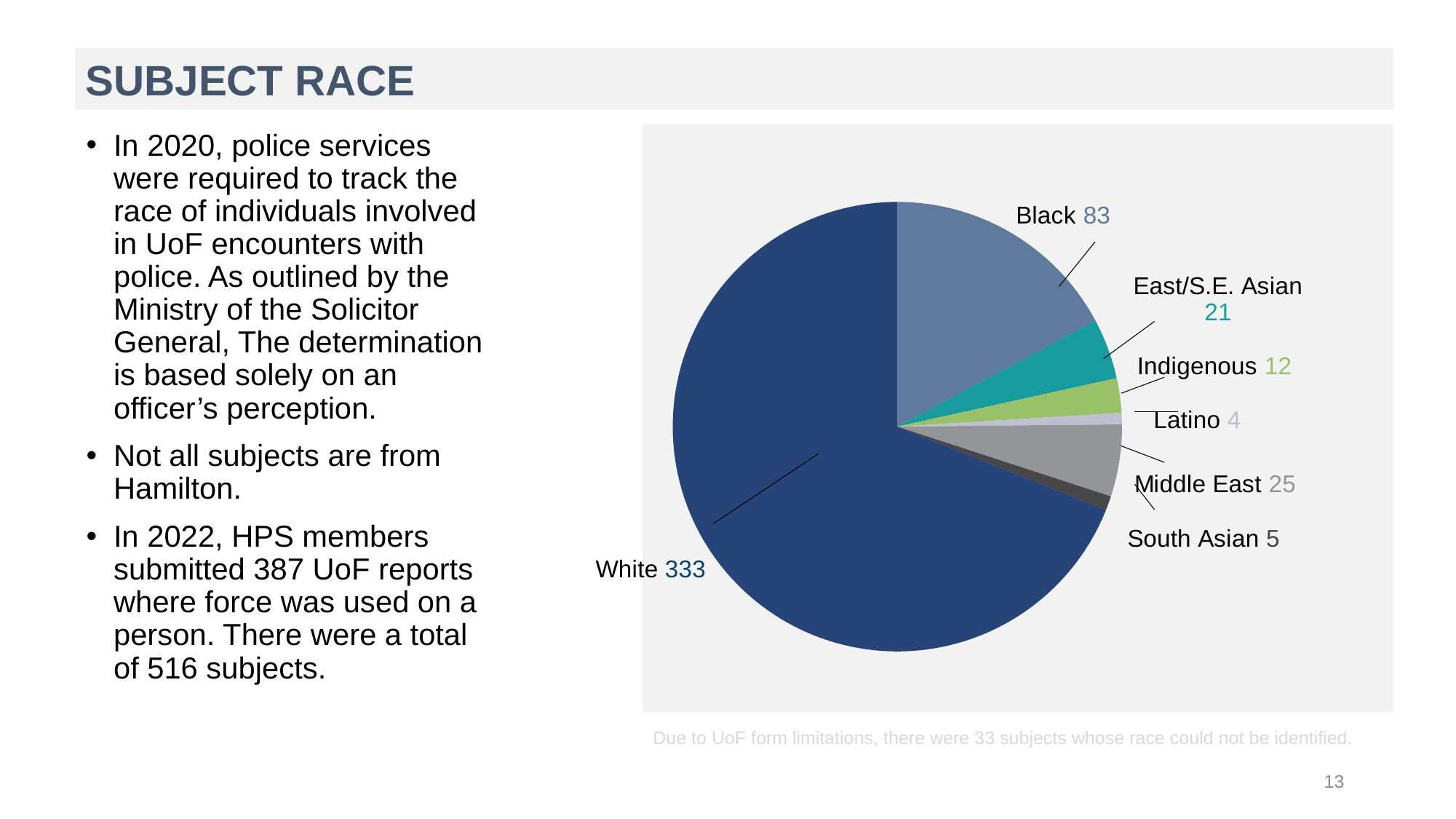
Which category has the smallest slice in the pie chart? Latino What is the value for Black in the pie chart? 83 What is the difference between the values for South Asian and Latino? 1 What type of chart is shown on the slide? Pie chart Which is larger, the value for Middle East or the value for East/S.E. Asian? Middle East What is the difference between the values for Black and Middle East? 58 What is the title of the slide containing the pie chart? SUBJECT RACE Which category has the largest slice in the pie chart? White What is the value for Middle East in the pie chart? 25 How many race categories are shown in the pie chart? 7 What is the value for Indigenous in the pie chart? 12 What is the value for White in the pie chart? 333